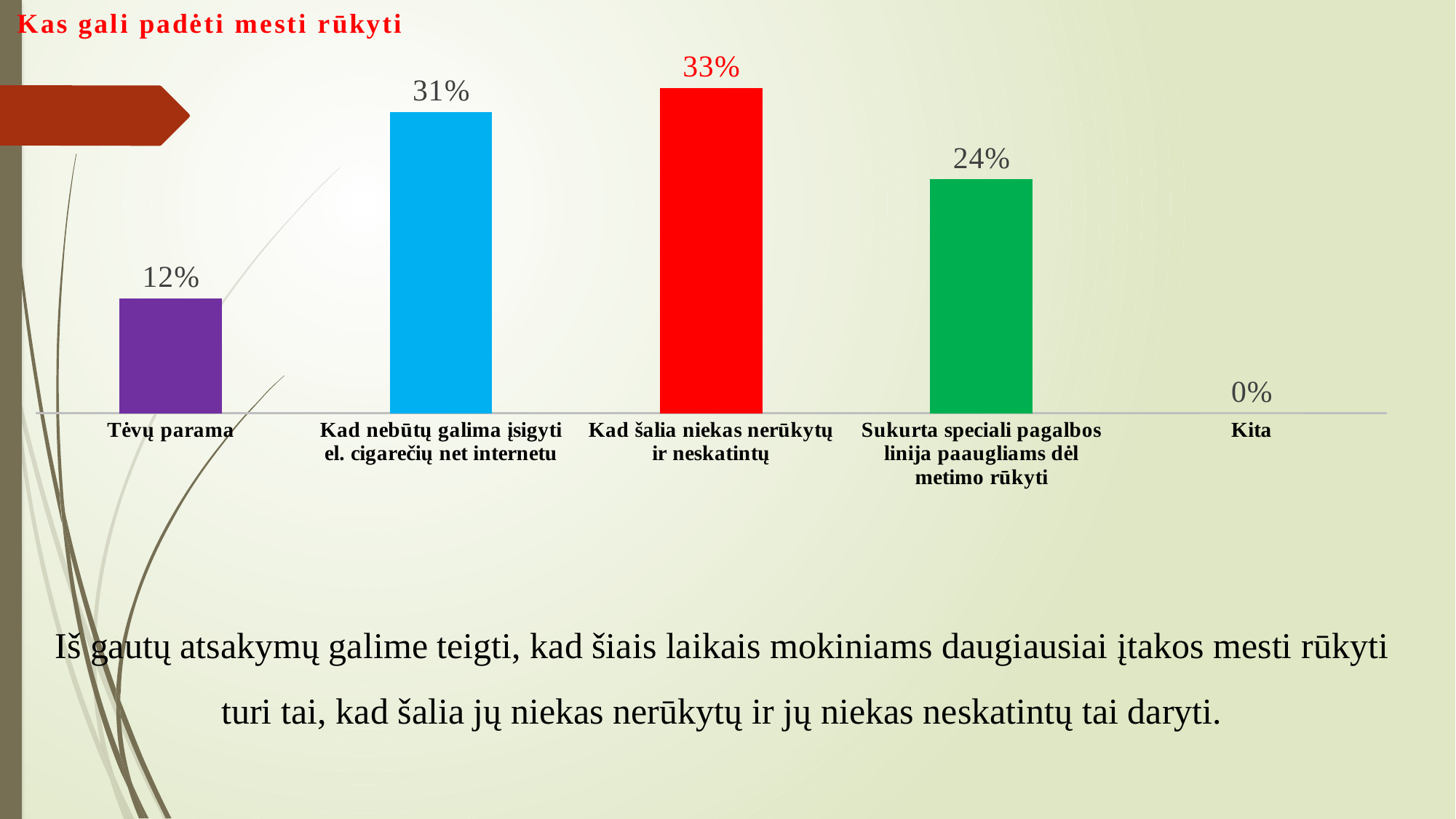
What colour is the bar for "Kad šalia niekas nerūkytų ir neskatintų"? Red What is the value for "Kita"? 0% What is the difference between the values for "Kad nebūtų galima įsigyti el. cigarečių net internetu" and "Tėvų parama"? 19% Which is larger: the value for "Kad nebūtų galima įsigyti el. cigarečių net internetu" or for "Sukurta speciali pagalbos linija paaugliams dėl metimo rūkyti"? Kad nebūtų galima įsigyti el. cigarečių net internetu Which category has the highest value? Kad šalia niekas nerūkytų ir neskatintų What is the value for "Tėvų parama"? 12% What is the title of the chart? Kas gali padėti mesti rūkyti What is the value for "Kad šalia niekas nerūkytų ir neskatintų"? 33% How many categories are shown in the chart? 5 What kind of chart is shown on the slide? Bar chart Which category has the lowest value? Kita What is the value for "Sukurta speciali pagalbos linija paaugliams dėl metimo rūkyti"? 24%